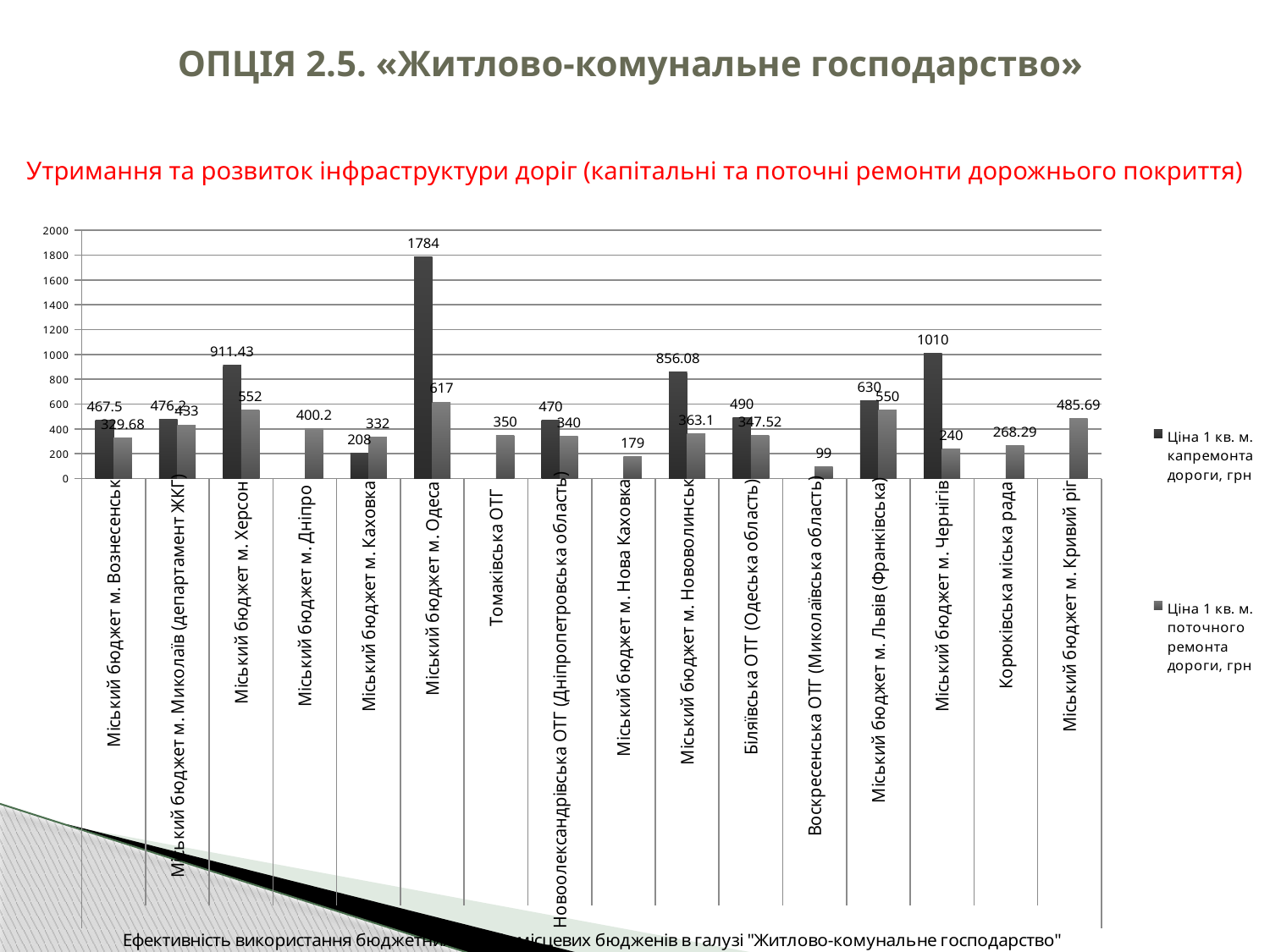
Is the 'Ціна 1 кв. м. капремонта дороги, грн' value for Міський бюджет м. Херсон greater or less than 800? greater How many series does the legend list? 2 What is the value of 'Ціна 1 кв. м. поточного ремонта дороги, грн' for Міський бюджет м. Кривий ріг? 485.69 What is the value of 'Ціна 1 кв. м. поточного ремонта дороги, грн' for Міський бюджет м. Херсон? 552 What is the value of 'Ціна 1 кв. м. капремонта дороги, грн' for Міський бюджет м. Одеса? 1784 What type of chart is shown on the slide? bar chart Which category has the lowest value for 'Ціна 1 кв. м. поточного ремонта дороги, грн'? Воскресенська ОТГ (Миколаївська область) What is the difference between the 'Ціна 1 кв. м. капремонта дороги, грн' value and the 'Ціна 1 кв. м. поточного ремонта дороги, грн' value for Міський бюджет м. Чернігів? 770 How many categories are shown on the x axis? 16 Which category has the highest value for 'Ціна 1 кв. м. капремонта дороги, грн'? Міський бюджет м. Одеса Which is larger: the 'Ціна 1 кв. м. капремонта дороги, грн' value for Міський бюджет м. Нововолинськ or for Міський бюджет м. Львів (Франківська)? Міський бюджет м. Нововолинськ What is the value of 'Ціна 1 кв. м. поточного ремонта дороги, грн' for Воскресенська ОТГ (Миколаївська область)? 99